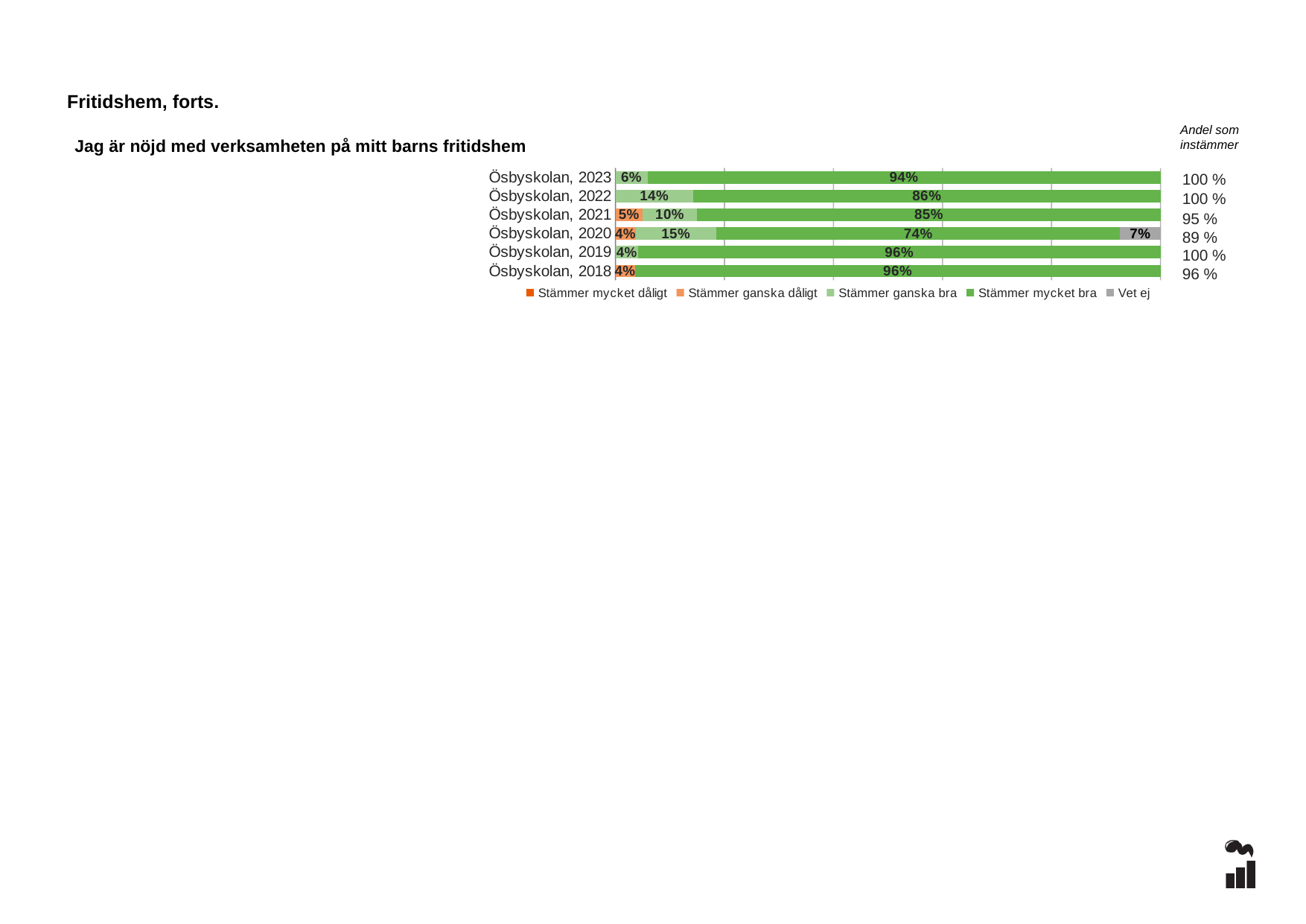
What kind of chart is shown on the slide? Stacked horizontal bar chart How many categories (bars) are shown in the chart? 6 What is the "Vet ej" share for Ösbyskolan, 2020? 7% What is the title of the chart? Jag är nöjd med verksamheten på mitt barns fritidshem Which year has the lowest "Stämmer mycket bra" share? Ösbyskolan, 2020 What is the difference in the "Stämmer mycket bra" share between Ösbyskolan, 2023 and Ösbyskolan, 2022? 8 percentage points What is the "Andel som instämmer" value shown for Ösbyskolan, 2020? 89 % What is the "Stämmer ganska bra" share for Ösbyskolan, 2022? 14% Which year has the lowest "Andel som instämmer" value? Ösbyskolan, 2020 How many series does the legend list? 5 Which has a larger "Stämmer mycket bra" share, Ösbyskolan, 2021 or Ösbyskolan, 2020? Ösbyskolan, 2021 What percentage of respondents answered "Stämmer mycket bra" for Ösbyskolan, 2023? 94%